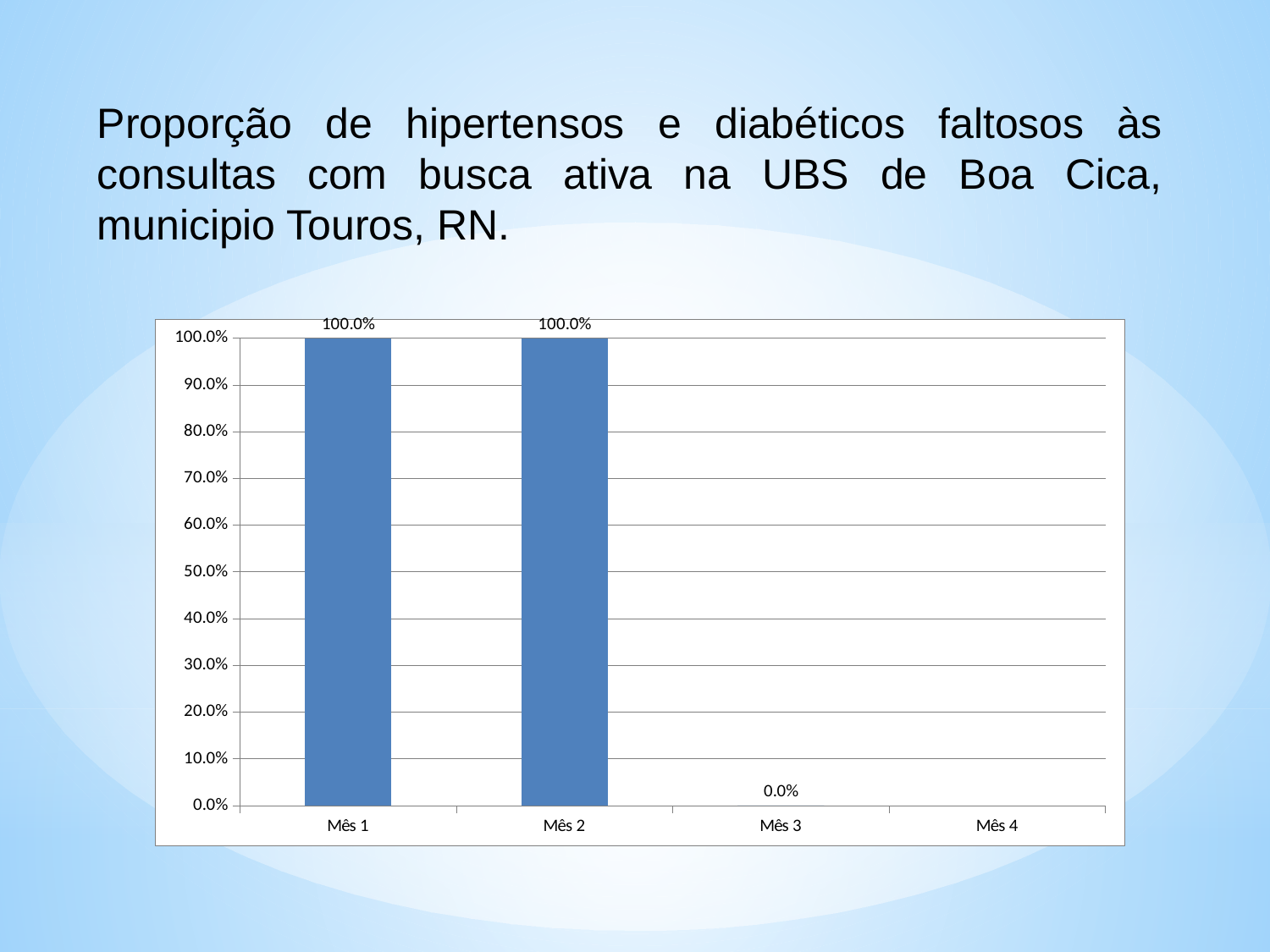
What kind of chart is shown on the slide? bar chart Is the value for Mês 2 greater or less than 50.0%? greater Is the value for Mês 3 greater or less than 10.0%? less What is the highest value shown on the y axis? 100.0% Which category is labelled with a value of 0.0%? Mês 3 How many categories are shown on the x axis? 4 Do the values rise or fall from Mês 2 to Mês 3? fall What is the value for Mês 2? 100.0% What is the value for Mês 1? 100.0% What is the difference between the values for Mês 2 and Mês 3? 100.0% Which of Mês 1 and Mês 3 has the larger value? Mês 1 What is the value for Mês 3? 0.0%